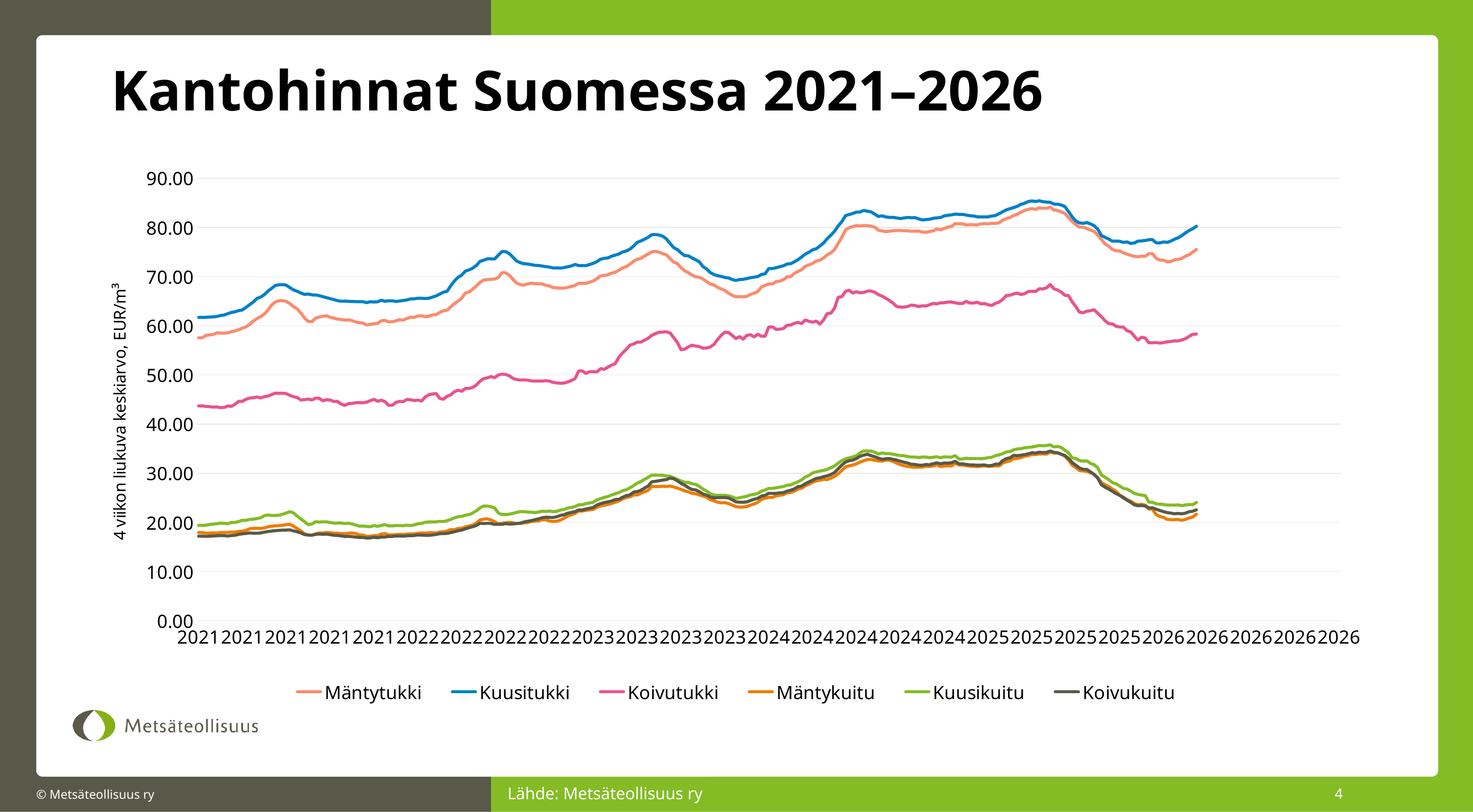
Is the peak value for Kuusikuitu greater or less than 40.00? less How many series does the legend list? 6 Which series has the highest values throughout the chart? Kuusitukki Is the peak value for Kuusitukki greater or less than 80.00? greater What is the title of the chart on the slide? Kantohinnat Suomessa 2021–2026 Does the Koivutukki series overall rise or fall from 2021 to 2026? rise Which is higher across the chart, Kuusitukki or Mäntytukki? Kuusitukki Is the value for Koivutukki at the start of 2021 greater or less than 50.00? less What is the label of the vertical axis? 4 viikon liukuva keskiarvo, EUR/m³ What kind of chart is shown on the slide? Line chart Which is higher across the chart, Koivutukki or Kuusikuitu? Koivutukki In which year does the Kuusitukki series reach its highest value? 2025